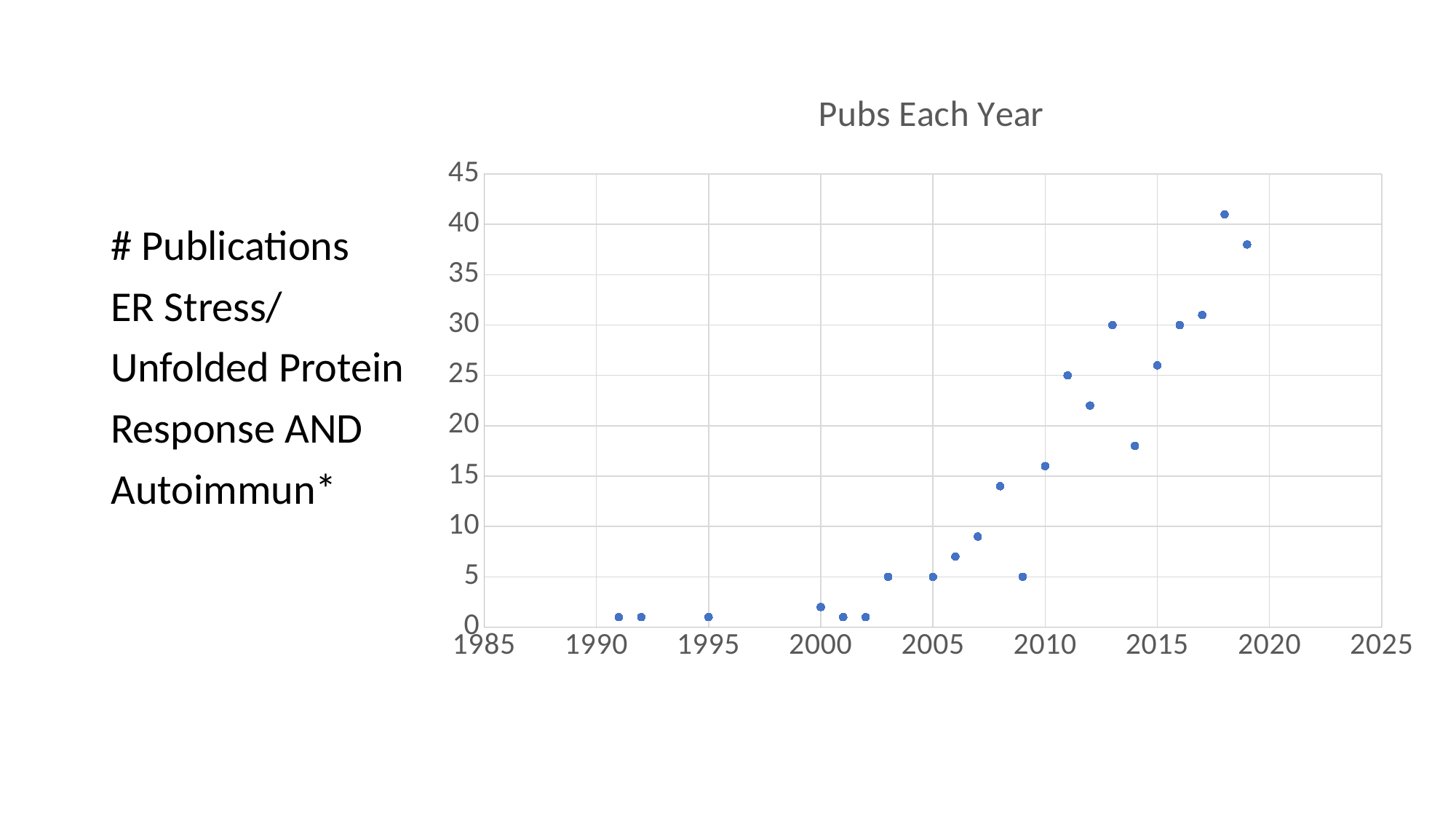
Which year has the larger value, 2010 or 2015? 2015 What is the highest value shown on the vertical axis? 45 Is the highest point on the chart greater or less than 35? greater What is the title of the chart? Pubs Each Year Which year has the larger value, 2005 or 2010? 2010 Is the value for 2000 greater or less than 5? less Do the values generally rise or fall as the years increase? rise Is the value for 1995 greater or less than 5? less What is the value plotted for the year 2005? 5 What kind of chart is shown on the slide? scatter chart